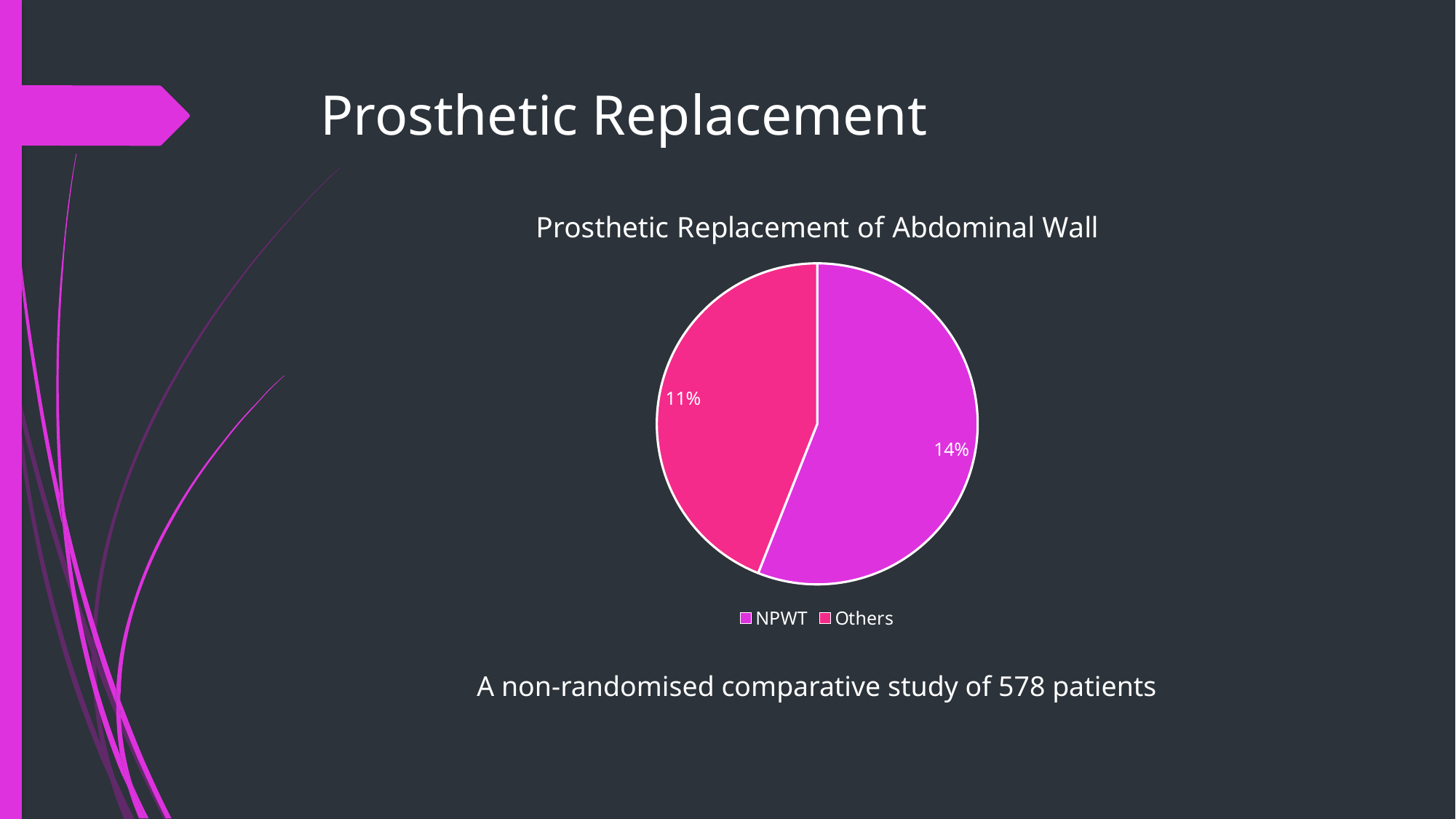
Which legend entry is shown in purple? NPWT What kind of chart is shown on the slide? pie chart Which category has the larger slice in the pie chart? NPWT What is the difference between the NPWT value and the Others value? 3 percentage points What value is shown for NPWT in the pie chart? 14% Is the value for NPWT larger or smaller than the value for Others? larger How many slices does the pie chart have? 2 What is the title of the chart? Prosthetic Replacement of Abdominal Wall What value is shown for Others in the pie chart? 11% Which category has the smaller slice in the pie chart? Others How many entries does the legend list? 2